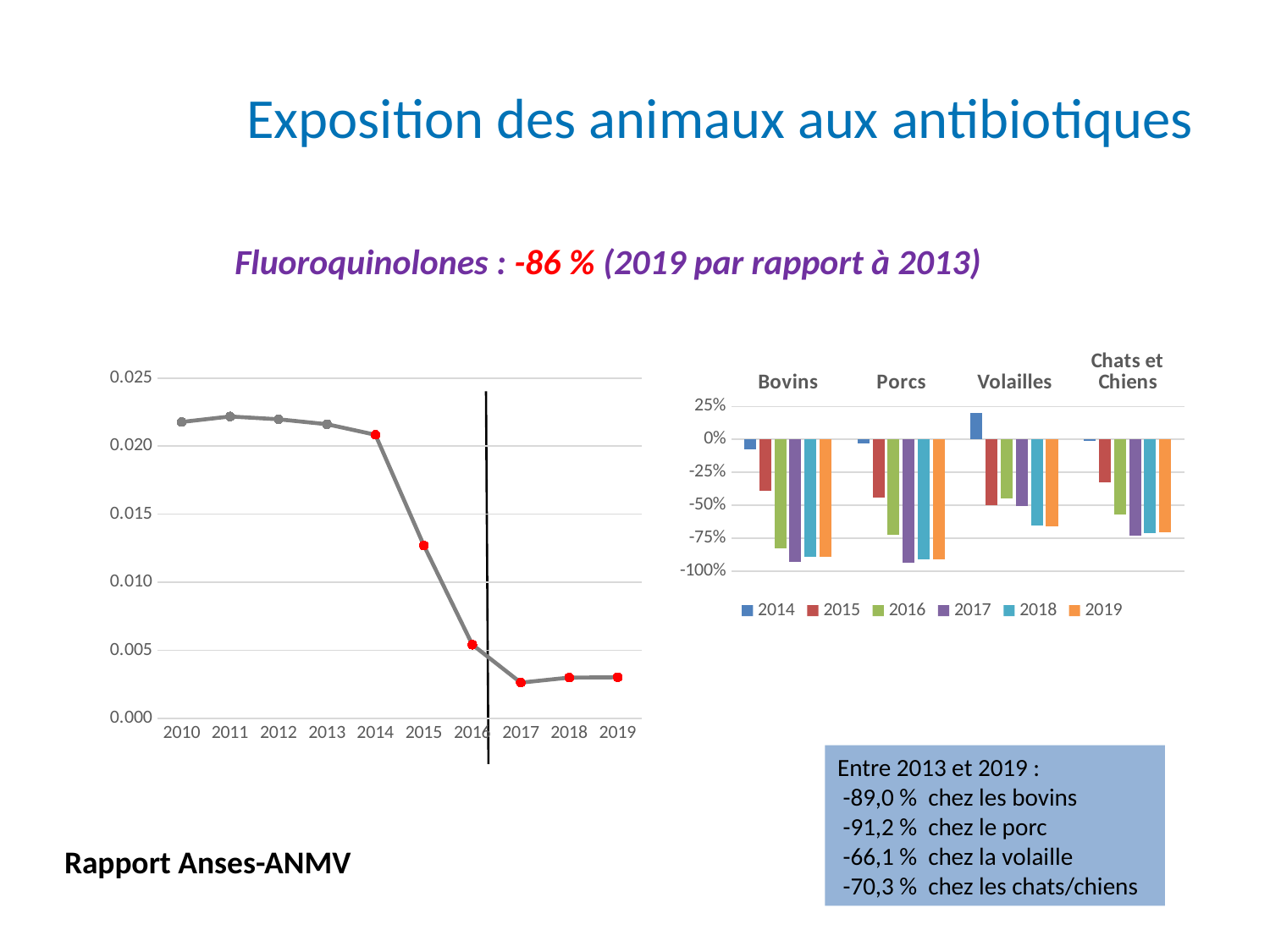
What kind of chart is the chart on the left of the slide? line chart In the bar chart on the right, how many series does the legend list? 6 In the line chart on the left, is the value for 2010 greater or less than 0.020? greater In the line chart on the left, is the value for 2019 greater or less than 0.005? less In the line chart on the left, is the value for 2015 greater or less than 0.015? less What kind of chart is the chart on the right of the slide? bar chart In the bar chart on the right, which category has the highest value for the 2014 series? Volailles In the line chart on the left, how many years are plotted along the x axis? 10 In the bar chart on the right, how many animal categories are shown? 4 In the line chart on the left, do the values rise or fall overall from 2010 to 2019? fall